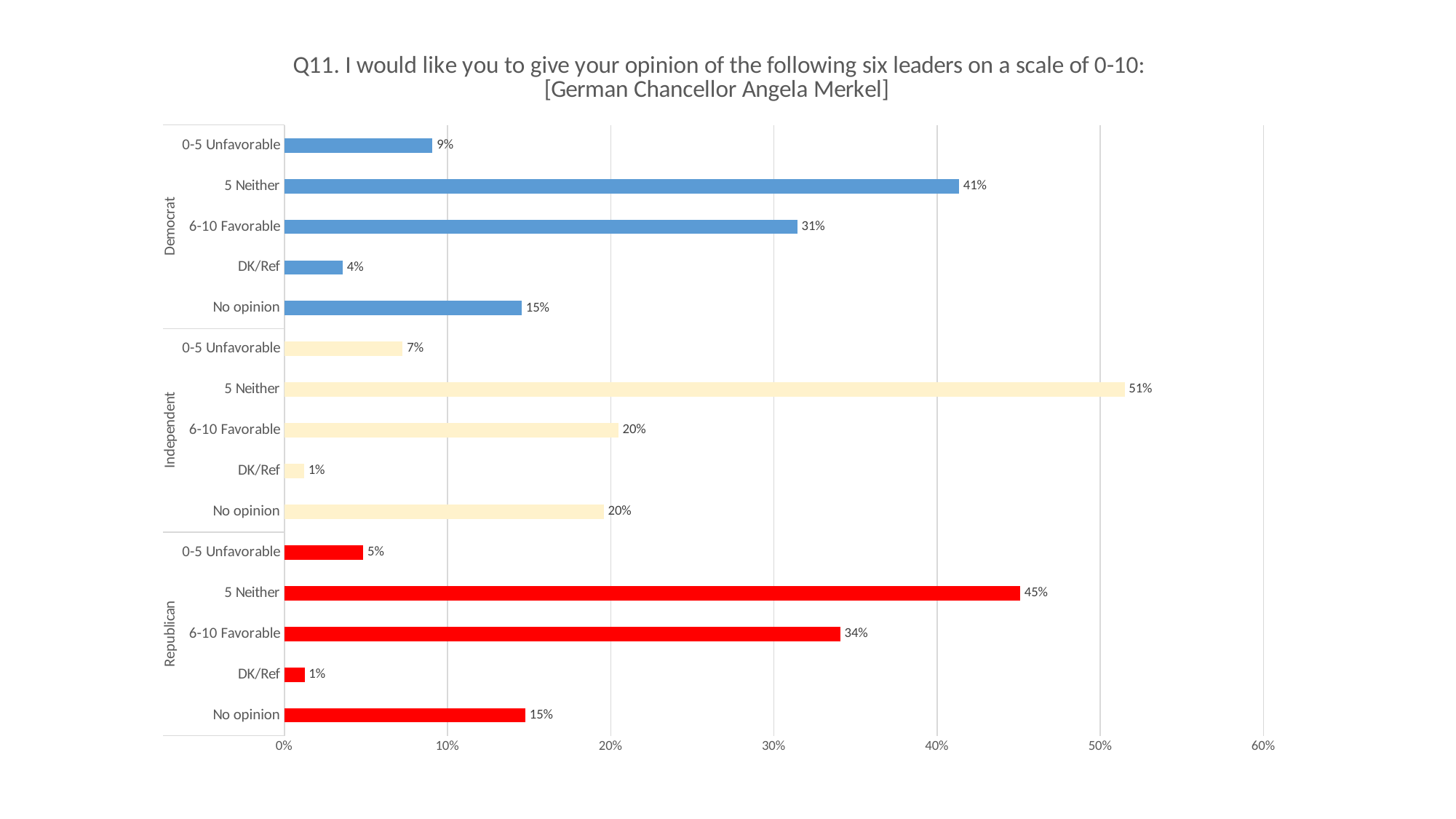
Which bar on the chart has the highest value? Independent 5 Neither What is the value for 'DK/Ref' among Independents? 1% Which is larger: '0-5 Unfavorable' for Democrats or '0-5 Unfavorable' for Republicans? Democrats What percentage of Democrats gave a '5 Neither' rating for Angela Merkel? 41% What kind of chart is shown on the slide? Bar chart How many bars are plotted on the chart in total? 15 Within the Democrat group, which category has the lowest value? DK/Ref What is the value for '6-10 Favorable' among Republicans? 34% What is the value for 'No opinion' among Independents? 20% What is the difference between the '6-10 Favorable' values for Republicans and Independents? 14% Is the value for '5 Neither' among Republicans greater or less than 40%? greater What colour are the bars for the Republican group? Red